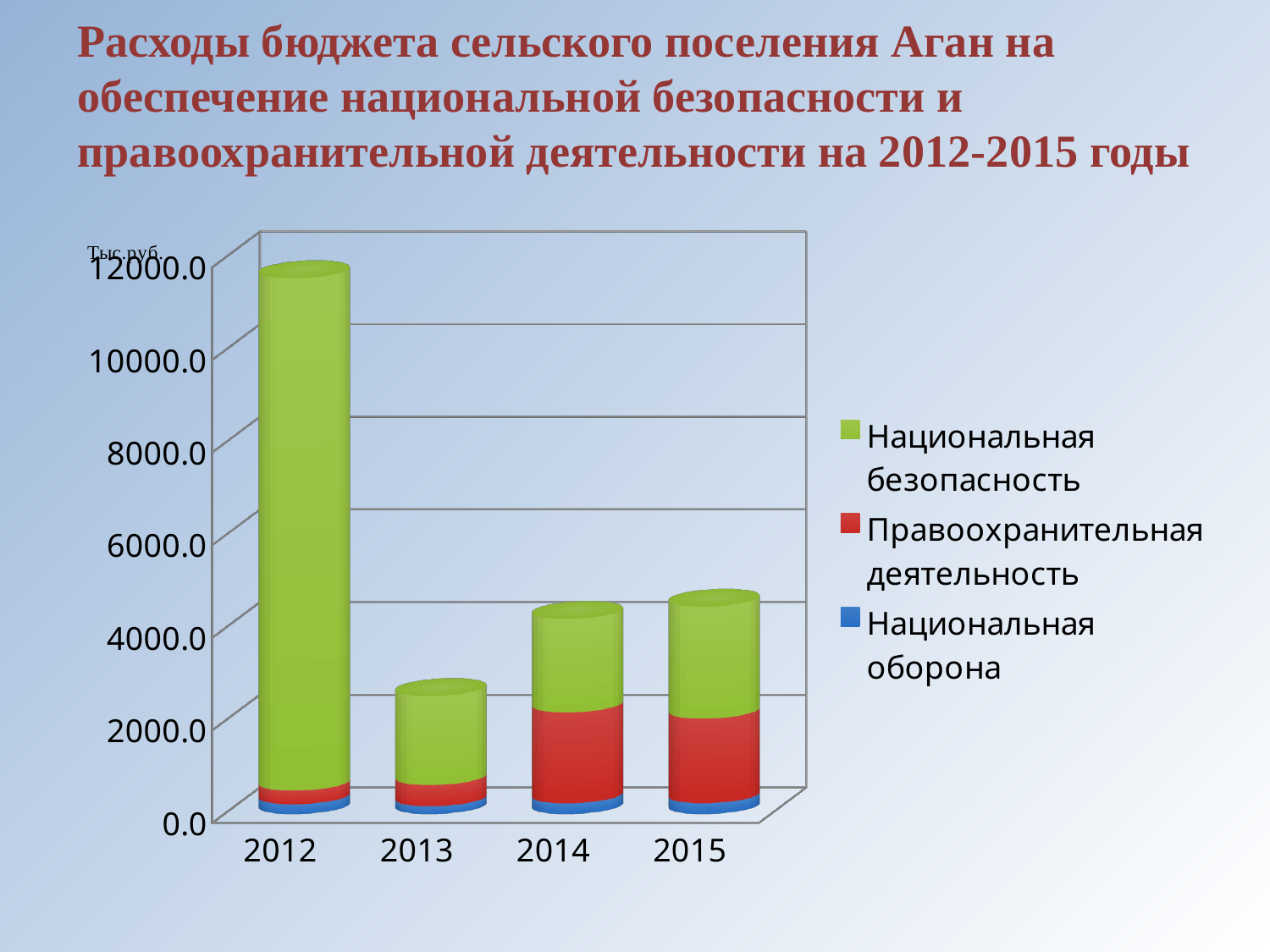
How many series does the chart legend list? 3 Is the total value for 2015 greater or less than 6000.0? less What kind of chart is shown on the slide? Stacked bar chart Which series makes up the largest part of the 2012 bar? Национальная безопасность Which total bar is larger, 2012 or 2013? 2012 Do the total bar values rise or fall from 2013 to 2015? rise Which year has the lowest total bar in the chart? 2013 Is the total value for 2013 greater or less than 4000.0? less How many years (categories) are shown on the x axis of the chart? 4 Which colour represents the series 'Национальная оборона' in the legend? Blue Which year has the highest total bar in the chart? 2012 Is the total value for 2012 greater or less than 10000.0? greater